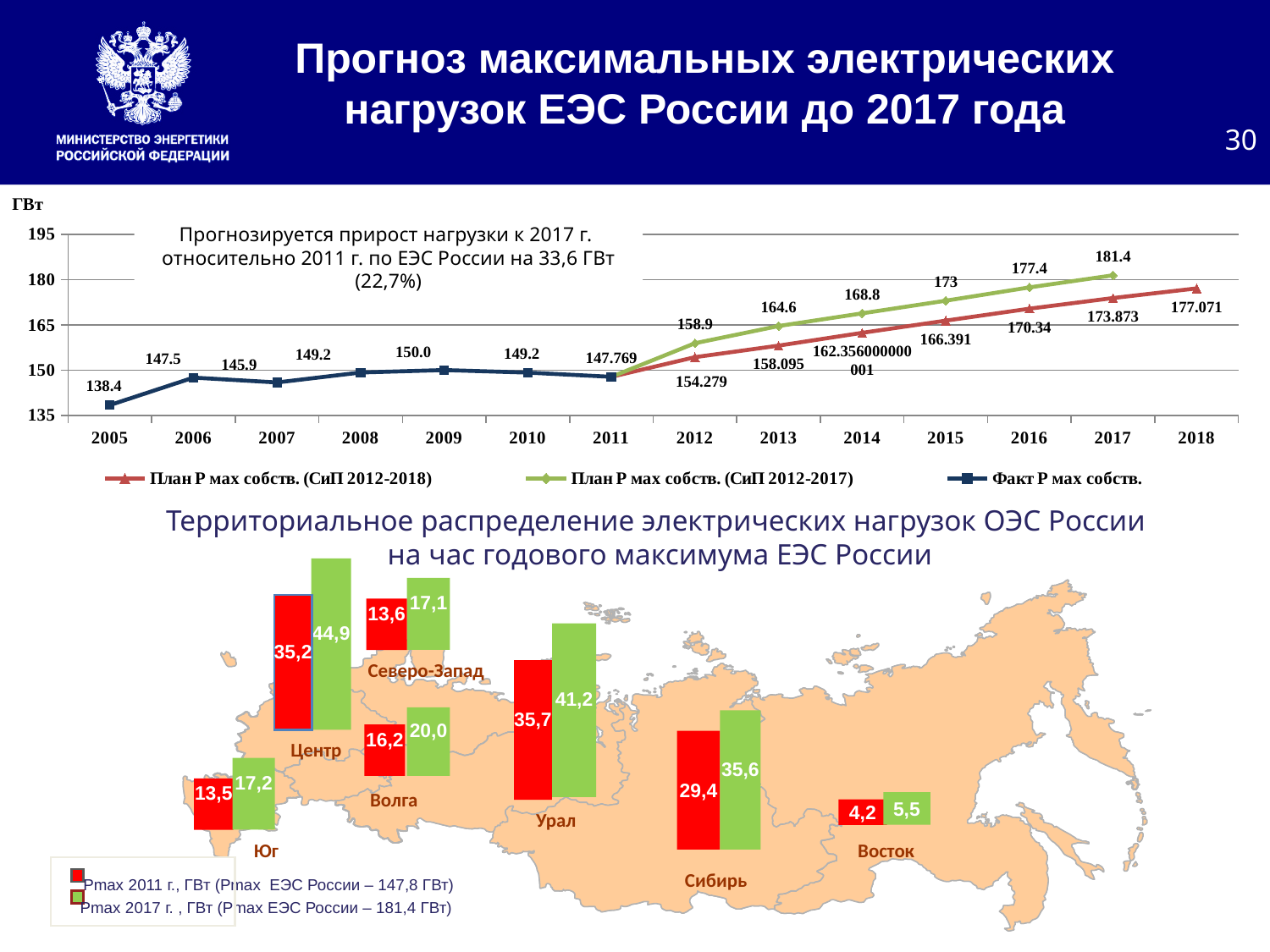
In the top line chart, how many series does the legend list? 3 In the bottom map chart, which region has the highest Pmax 2017 value? Центр In the top line chart, what is the value of the 'Факт Р max собств.' series for 2009? 150.0 In the bottom map chart, what is the difference between the Pmax 2017 and Pmax 2011 values for Сибирь? 6,2 In the top line chart, what is the difference between the 2017 values of the 'План Р max собств. (СиП 2012-2017)' series and the 'План Р max собств. (СиП 2012-2018)' series? 7.527 In the top line chart, does the 'План Р max собств. (СиП 2012-2017)' series rise or fall from 2012 to 2017? rise In the bottom map chart, what is the Pmax 2017 value for Урал? 41,2 In the bottom map chart, which region has the lowest Pmax 2011 value? Восток In the top line chart, what is the value of the 'План Р max собств. (СиП 2012-2018)' series for 2018? 177.071 What type of chart is the top chart on the slide? line chart In the top line chart, which year has the lowest value of the 'Факт Р max собств.' series? 2005 In the top line chart, what is the value of the 'План Р max собств. (СиП 2012-2017)' series for 2017? 181.4